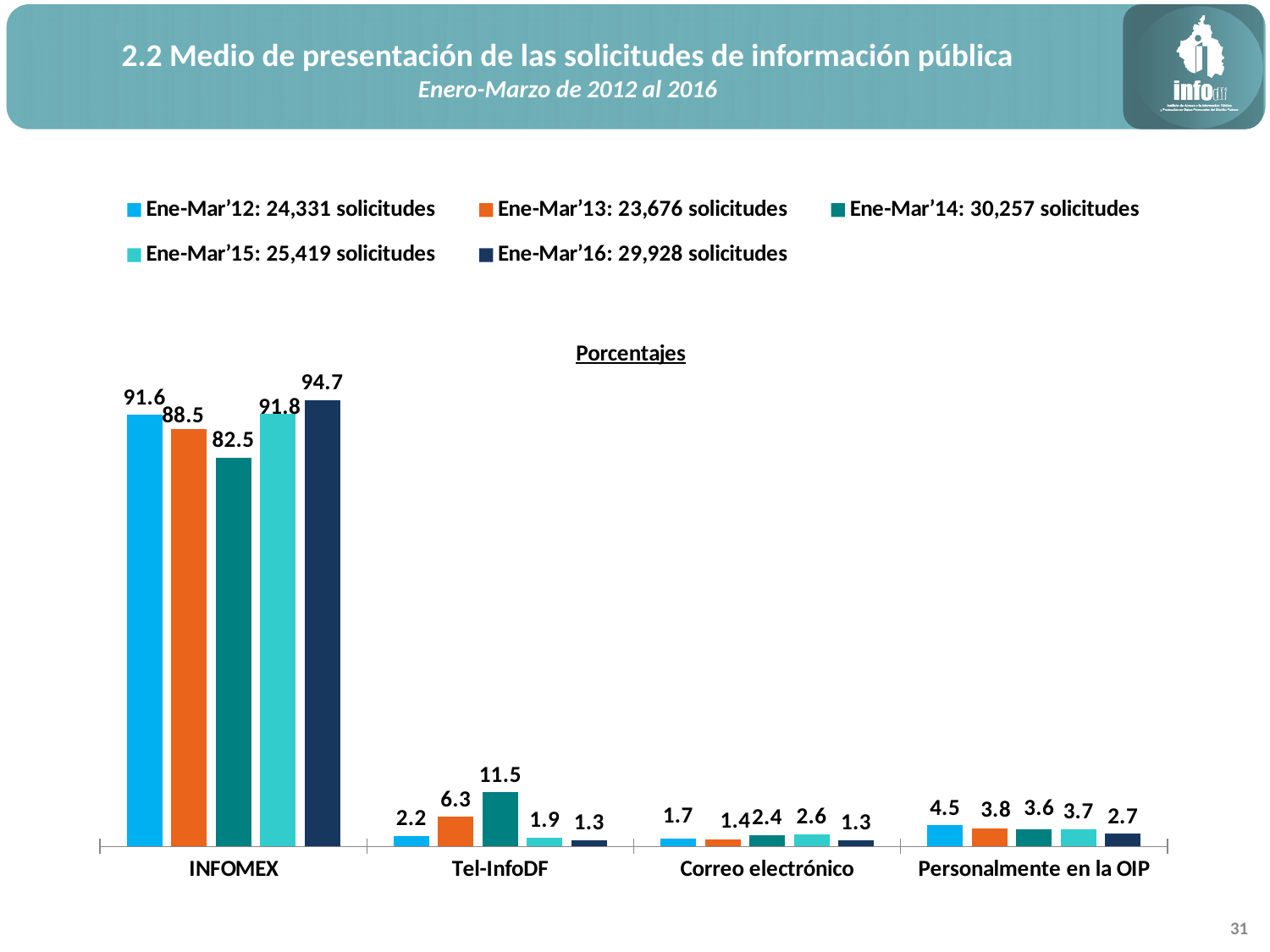
Which series has the lowest value for INFOMEX? Ene-Mar'14 What is the value for INFOMEX in the Ene-Mar'16 series? 94.7 How many solicitudes does the legend give for Ene-Mar'14? 30,257 solicitudes What is the value for Personalmente en la OIP in the Ene-Mar'12 series? 4.5 How many categories are shown on the x axis? 4 What is the value for Tel-InfoDF in the Ene-Mar'14 series? 11.5 Which is larger for Tel-InfoDF: the Ene-Mar'13 value or the Ene-Mar'12 value? Ene-Mar'13 Which series has the highest value for INFOMEX? Ene-Mar'16 What is the value for Correo electrónico in the Ene-Mar'15 series? 2.6 What is the difference between the Ene-Mar'16 and Ene-Mar'14 values for INFOMEX? 12.2 What kind of chart is shown on the slide? Bar chart How many series does the legend list? 5